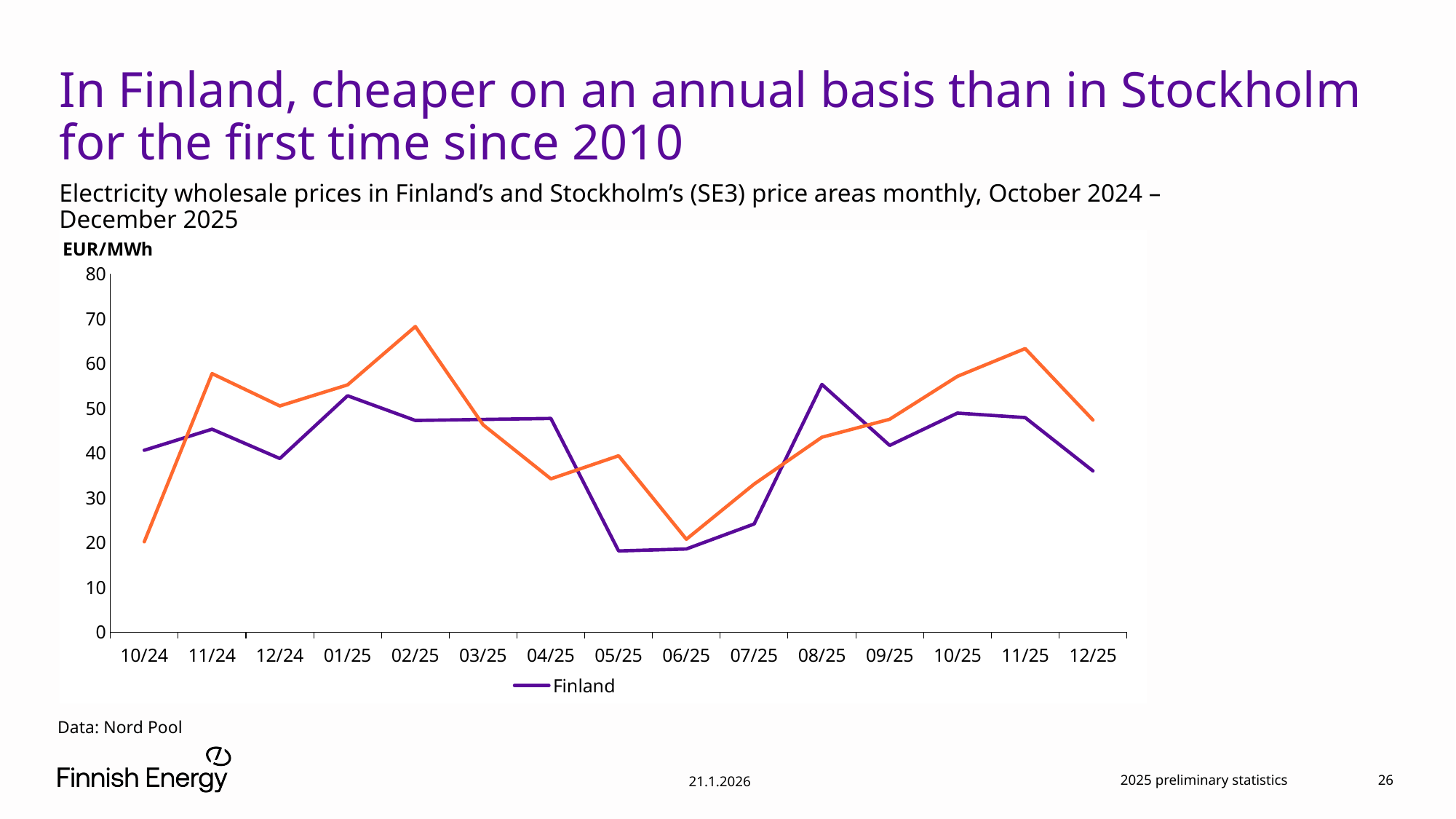
Is the value for Finland in 12/25 greater or less than 40? less In which month does the Finland line reach its highest value? 08/25 Does the Finland line rise or fall from 04/25 to 05/25? fall What unit is shown on the y axis? EUR/MWh How many monthly points are plotted along the x axis? 15 Which series is named in the legend? Finland Is the value for Finland in 01/25 greater or less than 50? greater Which is larger for Finland, the value in 01/25 or the value in 05/25? 01/25 How many series does the legend list? 1 What kind of chart is shown on the slide? line chart Is the value for Finland in 11/24 greater or less than 40? greater